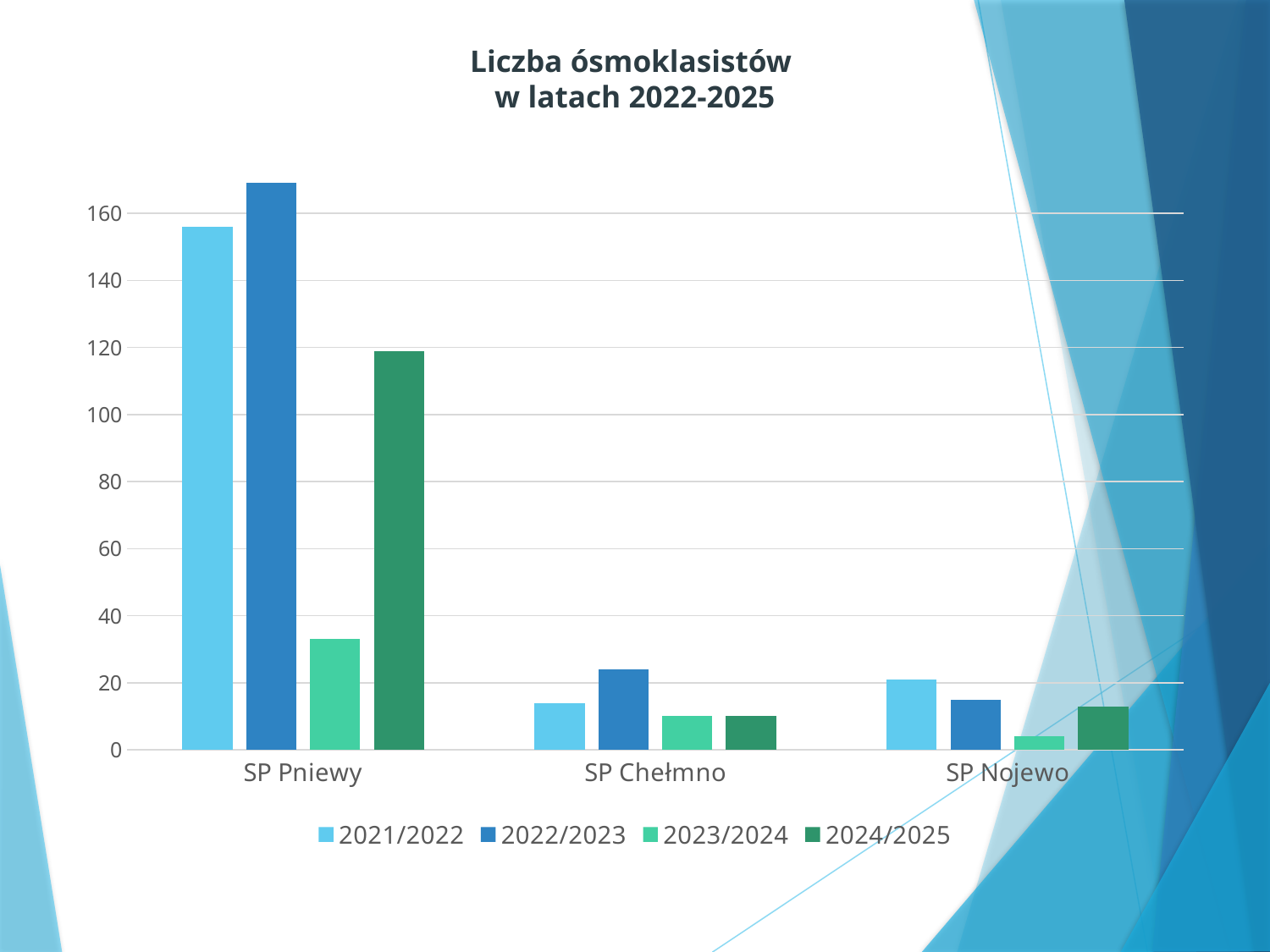
Is the value for SP Chełmno in 2022/2023 greater or less than 40? less Which is larger for SP Nojewo: the value for 2021/2022 or the value for 2023/2024? 2021/2022 For SP Pniewy, which school year has the highest value? 2022/2023 Is the value for SP Pniewy in 2022/2023 greater or less than 160? greater For SP Chełmno, which school year has the highest value? 2022/2023 How many schools (categories) are shown on the x axis? 3 What kind of chart is shown on the slide? bar chart For SP Pniewy, which school year has the lowest value? 2023/2024 Which school has the highest bar in the chart? SP Pniewy Is the value for SP Pniewy in 2024/2025 greater or less than 100? greater What is the title of the chart? Liczba ósmoklasistów w latach 2022-2025 How many series does the legend list? 4